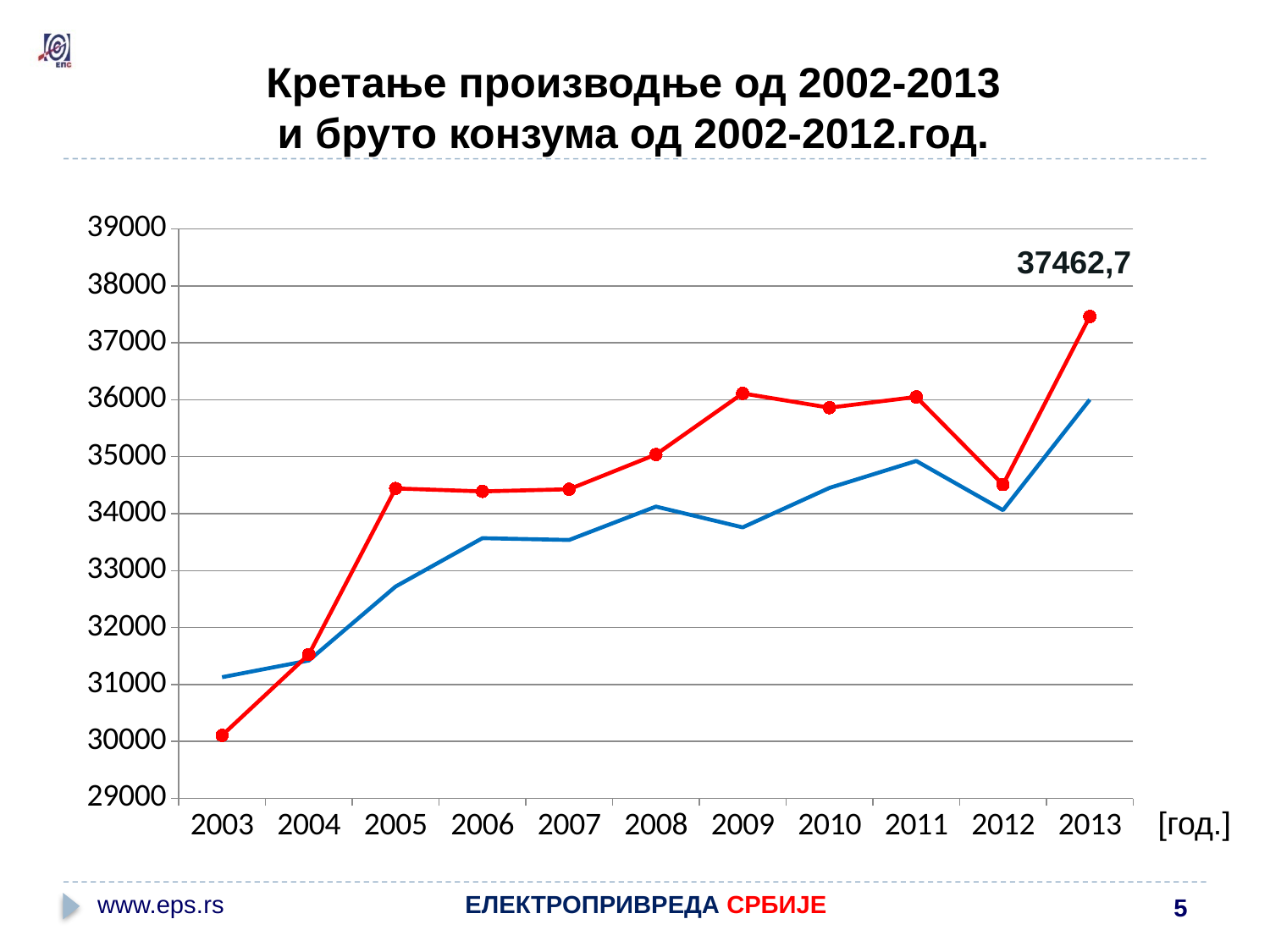
How many lines are plotted on the chart? 2 What unit label is shown at the end of the x axis? [год.] What kind of chart is shown on the slide? line chart In 2009, which line has the higher value, the red line or the blue line? the red line Is the value of the red line in 2003 greater or less than 31000? less How many years are shown on the x axis? 11 Is the value of the blue line in 2013 greater or less than 35000? greater In 2003, which line has the higher value, the red line or the blue line? the blue line In which year does the red line have its lowest value? 2003 What is the labelled value of the red line in 2013? 37462,7 Does the red line rise or fall from 2011 to 2012? fall In which year does the red line reach its highest value? 2013